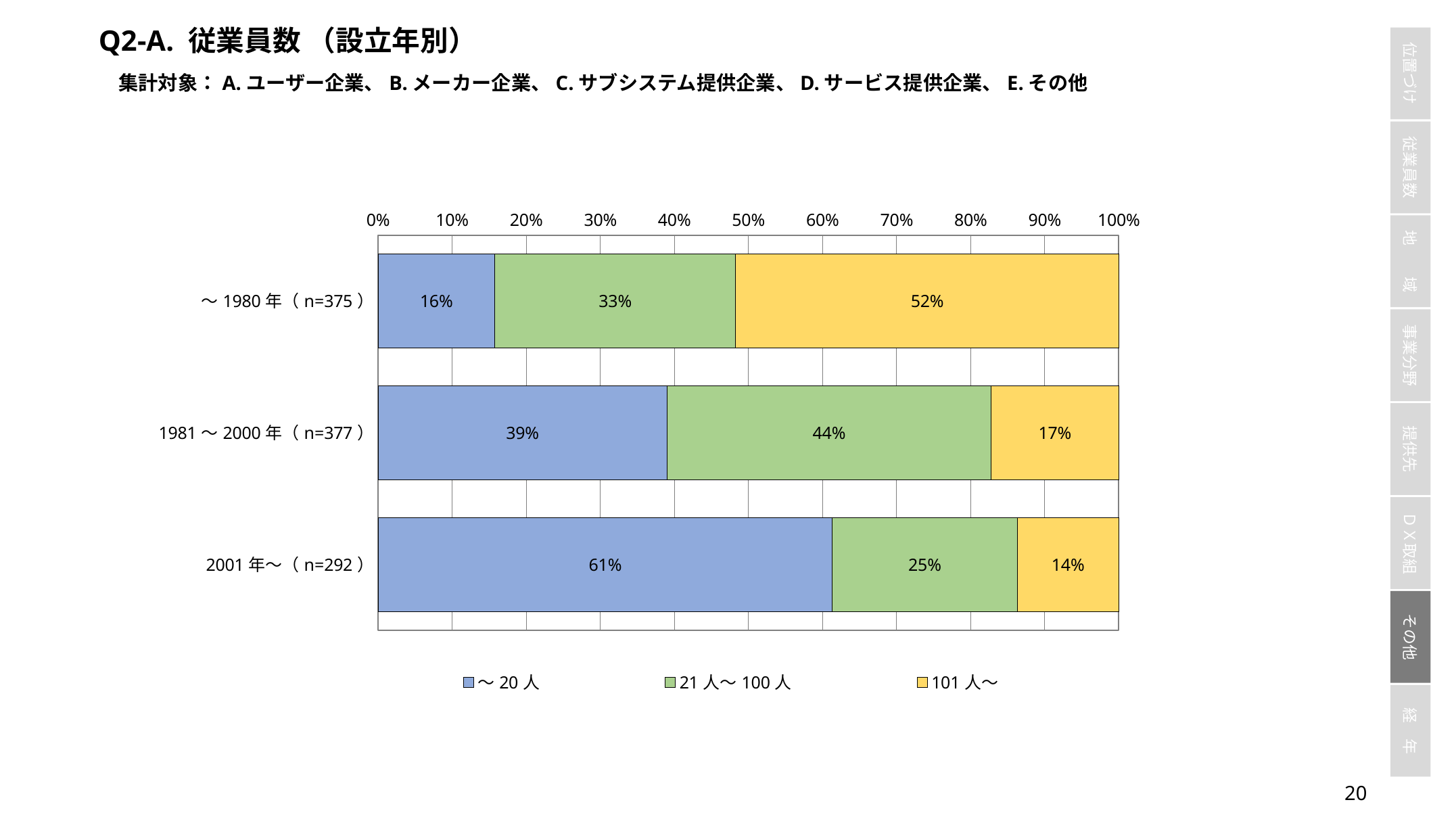
How many series does the legend list? 3 Which founding-year category has the highest share of 101人～ companies? ～1980年 Does the share of ～20人 companies rise or fall as the founding-year category moves from ～1980年 to 2001年～? Rise What percentage of companies founded in 2001 or later (2001年～) have ～20人 employees? 61% What kind of chart is shown on the slide? Stacked bar chart What is the sample size (n) for the 1981～2000年 category? n=377 Which is larger: the 21人～100人 value for 1981～2000年 or for 2001年～? 1981～2000年 How many founding-year categories are shown on the chart? 3 What is the difference between the ～20人 values for 2001年～ and ～1980年? 45% What is the value for 21人～100人 in the 1981～2000年 category? 44% What is the value for 101人～ in the ～1980年 category? 52% Which founding-year category has the lowest share of ～20人 companies? ～1980年